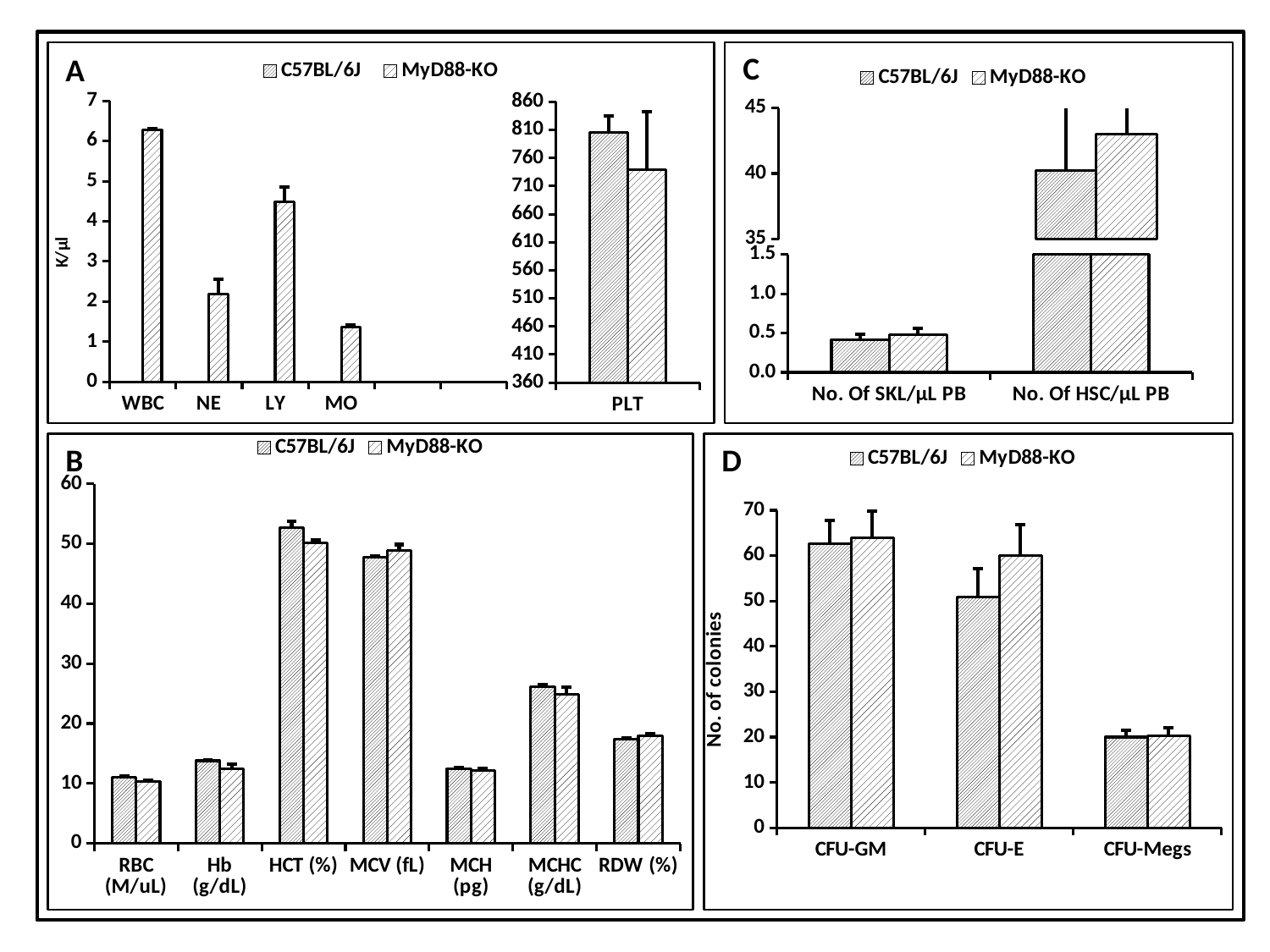
In panel D, how many series does the legend list? 2 In panel D, is the MyD88-KO value for CFU-Megs greater or less than 30? less In panel D, which category has the lowest values for both series? CFU-Megs In panel C, is the C57BL/6J value for No. Of HSC/µL PB greater or less than 35? greater In panel B, how many categories are shown on the x axis? 7 In panel A, which of the categories WBC, NE, LY and MO has the highest value? WBC In panel D, how many categories are shown on the x axis? 3 What kind of chart is panel D? bar chart In panel D, is the C57BL/6J value for CFU-GM greater or less than 60? greater In panel B, which category has the highest values? HCT (%) In panel D, for CFU-E, which series has the larger value, C57BL/6J or MyD88-KO? MyD88-KO